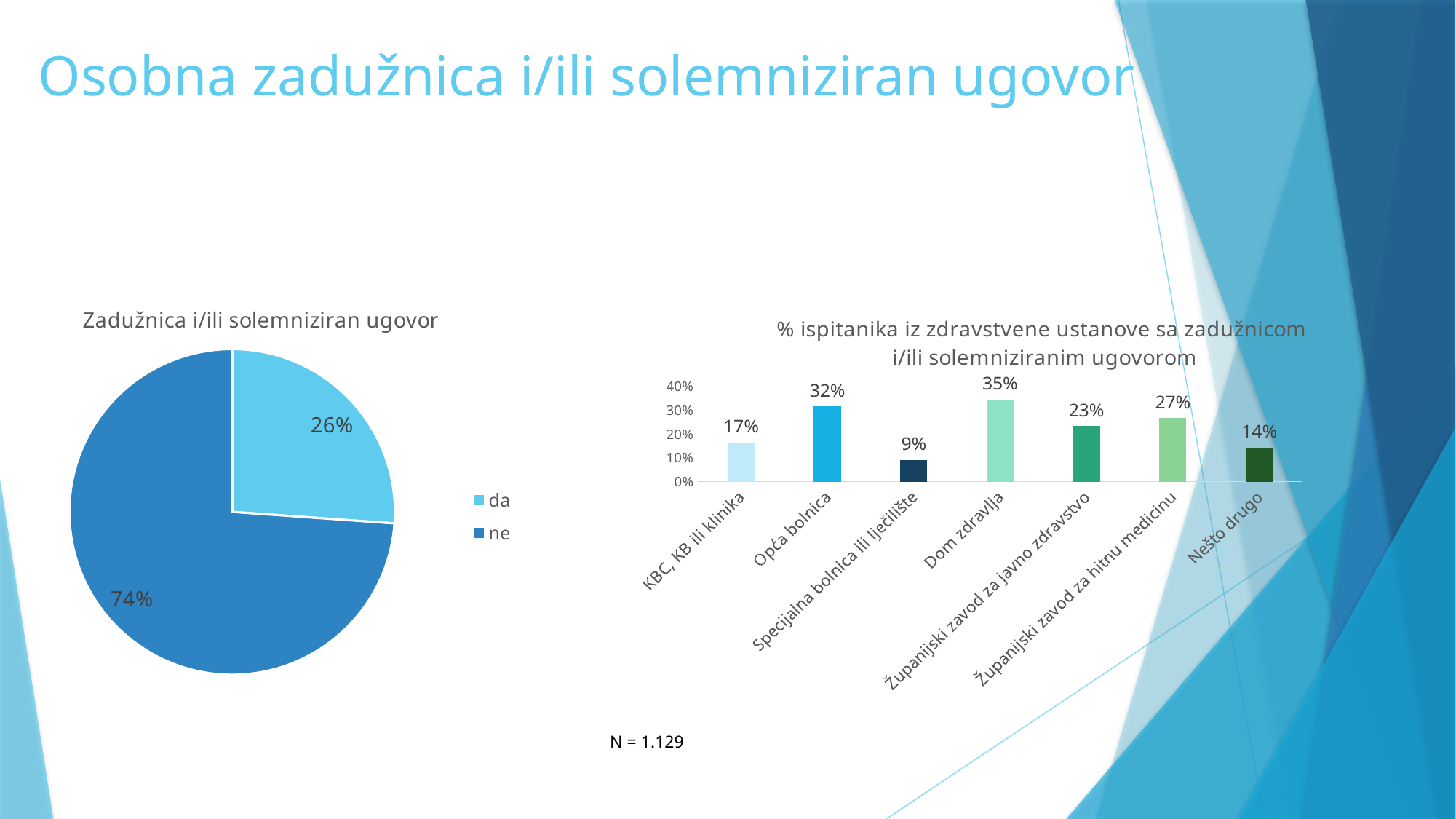
What kind of chart is the chart on the right of the slide? bar chart In the bar chart on the right, which category has the highest value? Dom zdravlja In the bar chart on the right, which category has the lowest value? Specijalna bolnica ili lječilište How many entries does the legend of the pie chart on the left list? 2 What kind of chart is the chart on the left of the slide? pie chart In the pie chart 'Zadužnica i/ili solemniziran ugovor', what share is labelled 'da'? 26% In the bar chart on the right, what is the value for 'Opća bolnica'? 32% How many categories are shown in the bar chart on the right? 7 In the pie chart on the left, which slice is larger, 'da' or 'ne'? ne In the pie chart 'Zadužnica i/ili solemniziran ugovor', what share is labelled 'ne'? 74% In the bar chart on the right, what is the value for 'Županijski zavod za hitnu medicinu'? 27% In the bar chart on the right, what is the difference between the values for 'Dom zdravlja' and 'KBC, KB ili klinika'? 18%